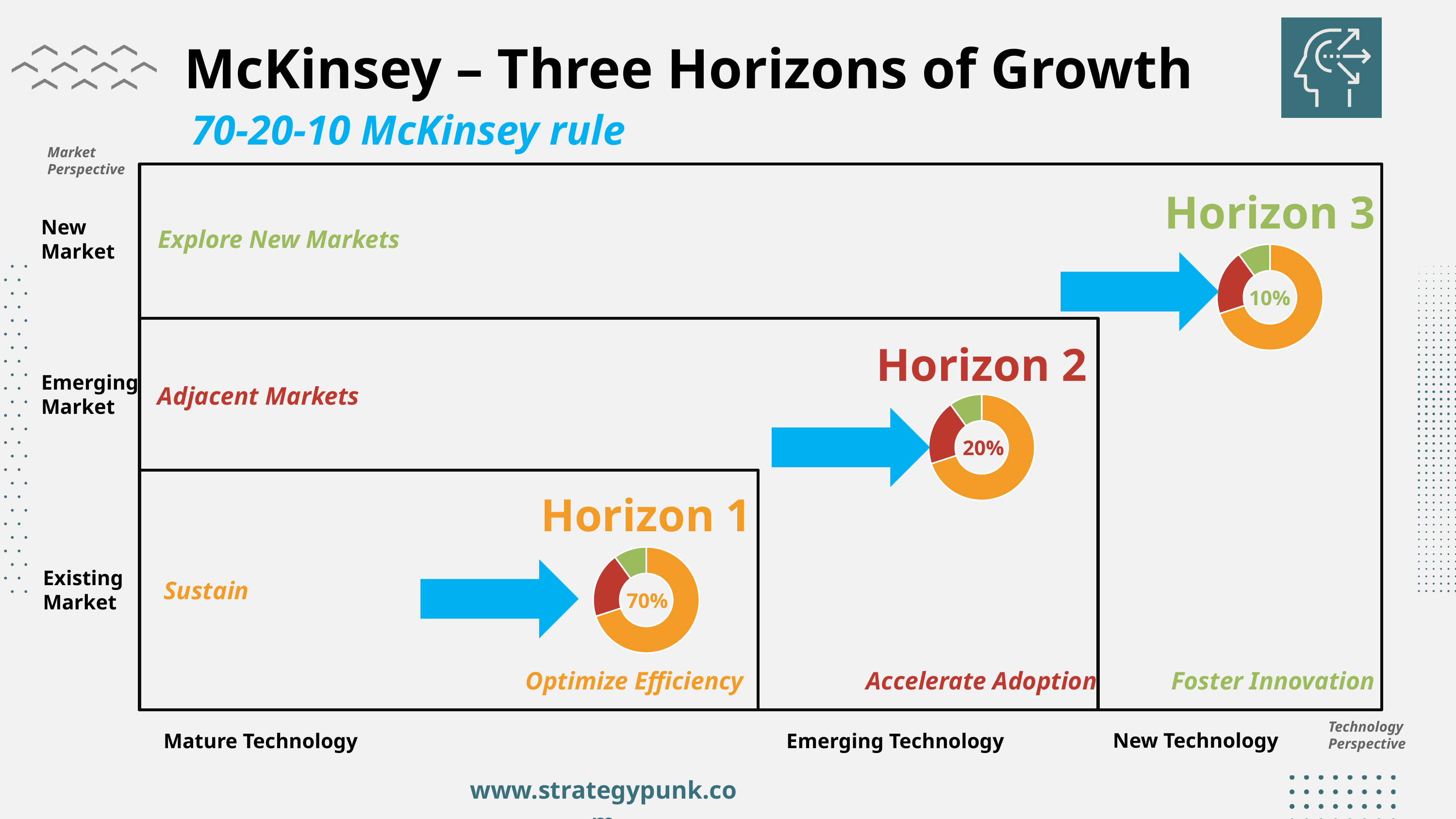
What is the difference between the percentage printed for Horizon 1 and the percentage printed for Horizon 2? 50 percentage points What percentage is printed in the centre of the Horizon 1 donut chart? 70% In the Horizon 1 donut chart, which colour is the largest slice? Orange What kind of chart is used to show the percentage for each horizon? Donut (pie) chart How many slices does the Horizon 1 donut chart have? 3 What is the total of the three percentages printed in the centres of the donut charts? 100% Which horizon's donut chart shows the lowest printed percentage? Horizon 3 Which horizon's donut chart shows the highest printed percentage? Horizon 1 What percentage is printed in the centre of the Horizon 2 donut chart? 20% Which is larger, the percentage printed for Horizon 2 or for Horizon 3? Horizon 2 What percentage is printed in the centre of the Horizon 3 donut chart? 10% How many donut charts are shown on the slide? 3